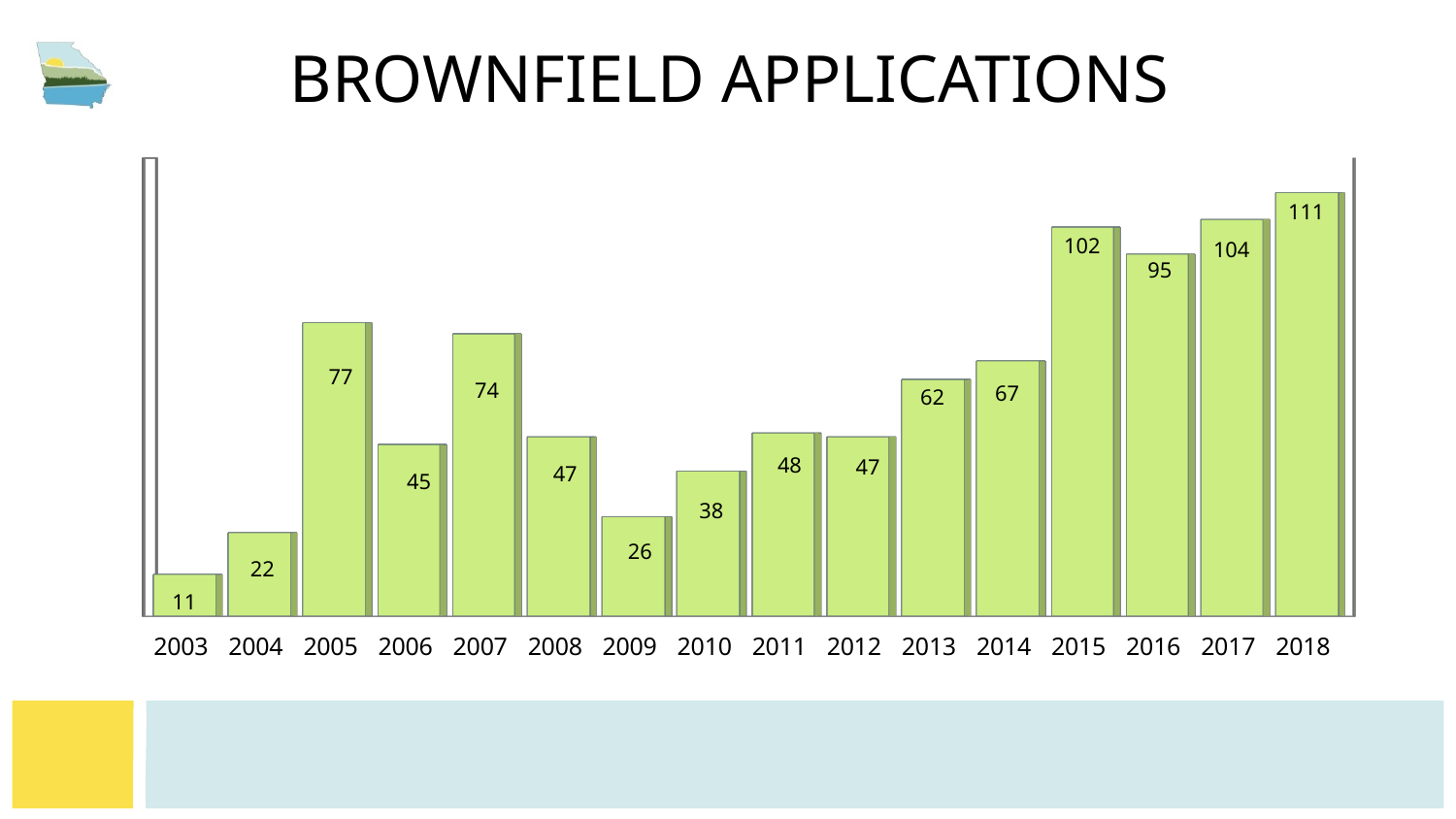
Which year had more brownfield applications, 2007 or 2013? 2007 Which year has the lowest number of brownfield applications? 2003 Which year had more brownfield applications, 2010 or 2012? 2012 What is the number of brownfield applications in 2018? 111 Which year has the highest number of brownfield applications? 2018 What is the difference between the number of applications in 2005 and 2004? 55 What is the difference between the number of applications in 2015 and 2016? 7 What kind of chart is shown on the slide? Bar chart How many years are shown on the chart? 16 What is the title of the chart? BROWNFIELD APPLICATIONS What is the number of brownfield applications in 2005? 77 What is the number of brownfield applications in 2009? 26